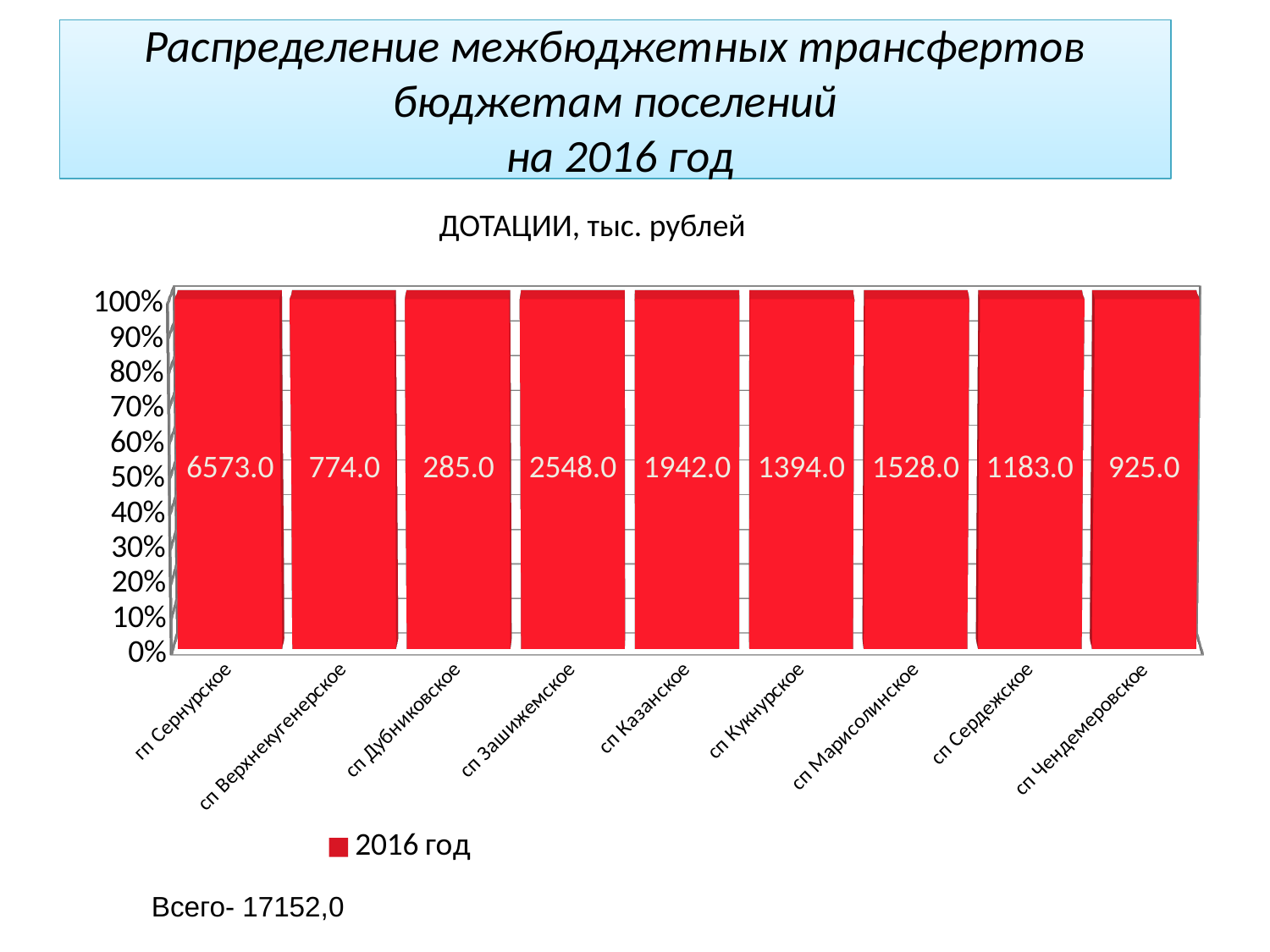
Which category has the highest labelled value? гп Сернурское What is the data label value for гп Сернурское? 6573.0 What kind of chart is shown? bar chart How many categories are shown on the x axis? 9 How many series does the legend list? 1 What is the data label value for сп Зашижемское? 2548.0 What is the data label value for сп Кукнурское? 1394.0 What is the difference between the labelled values for сп Зашижемское and сп Казанское? 606.0 What is the title shown above the chart? ДОТАЦИИ, тыс. рублей Which has the larger labelled value, сп Марисолинское or сп Сердежское? сп Марисолинское Which category has the lowest labelled value? сп Дубниковское What is the data label value for сп Чендемеровское? 925.0